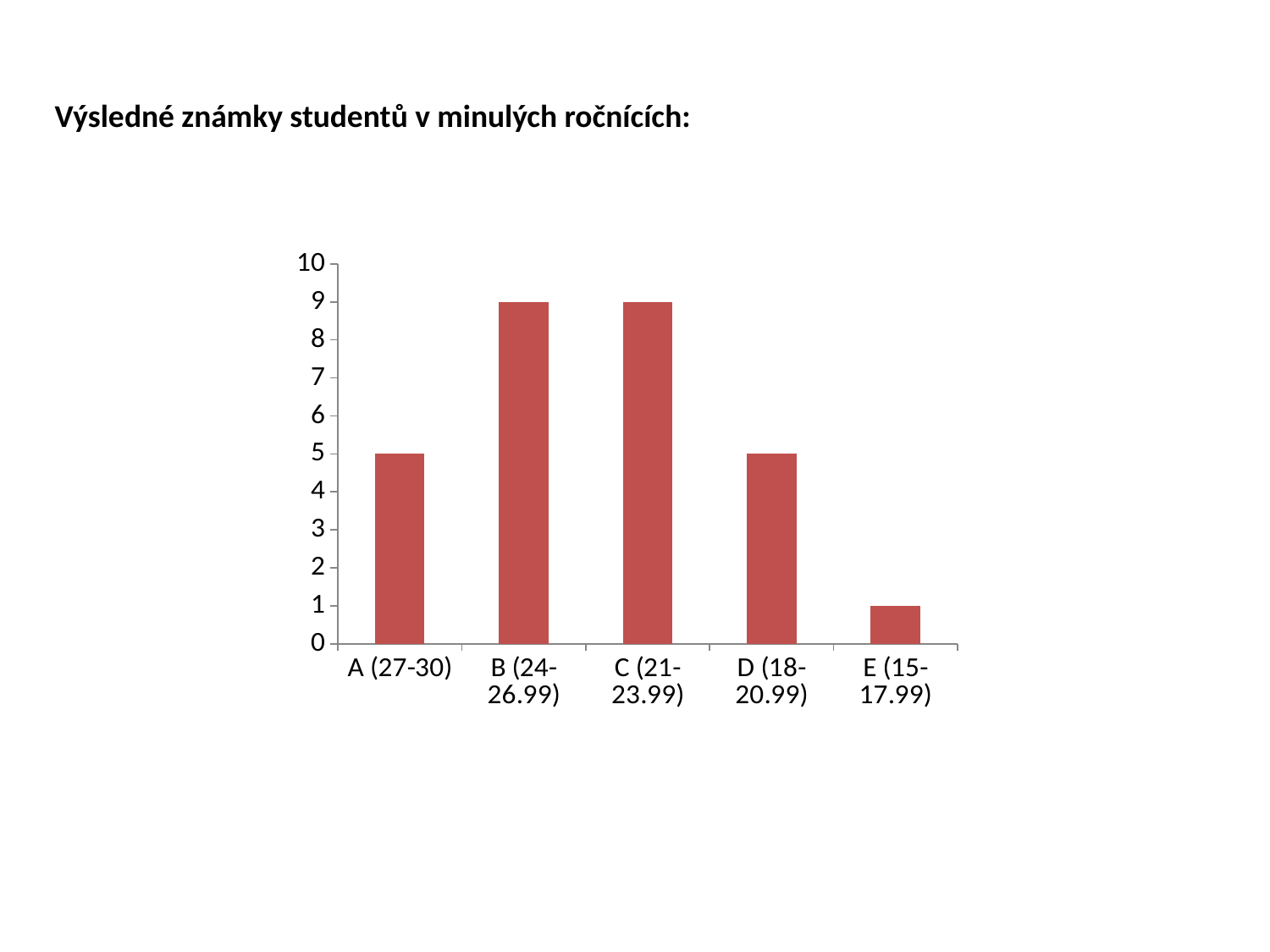
What is the value for E (15-17.99)? 1 What is the value for B (24-26.99)? 9 Which is larger, the value for C (21-23.99) or the value for D (18-20.99)? C (21-23.99) What kind of chart is shown on the slide? bar chart What is the difference between the values for D (18-20.99) and E (15-17.99)? 4 What is the value for D (18-20.99)? 5 What is the value for A (27-30)? 5 Is the value for B (24-26.99) greater or less than 8? greater Which category has the lowest value? E (15-17.99) What is the difference between the values for B (24-26.99) and A (27-30)? 4 How many categories are shown on the x axis? 5 What is the title text above the chart? Výsledné známky studentů v minulých ročnících: